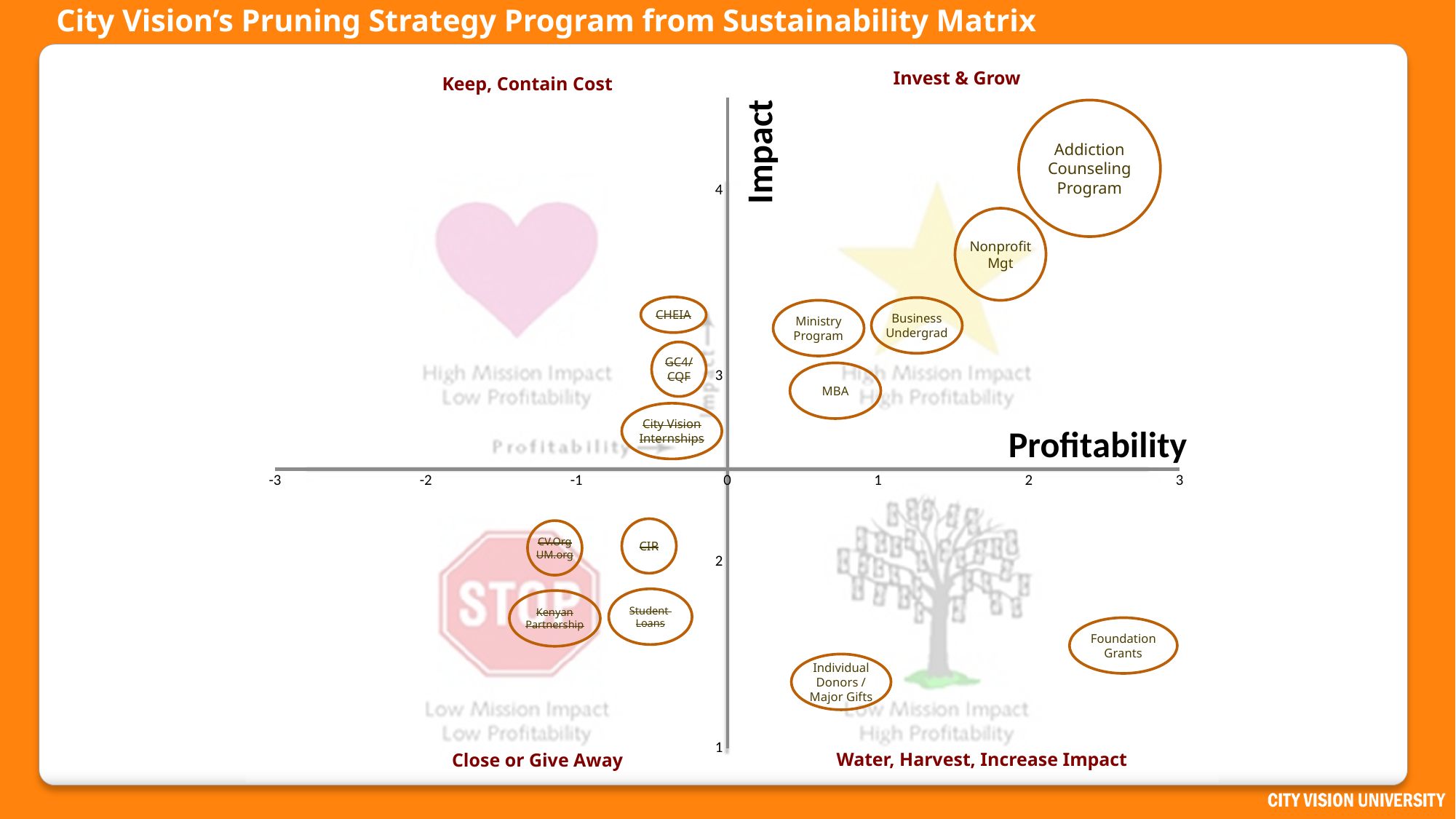
Which program has the highest Impact value? Addiction Counseling Program Is the Profitability value for Addiction Counseling Program greater or less than 2? greater Which program has the lowest Impact value? Individual Donors / Major Gifts What kind of chart is shown on the slide? Scatter (bubble) chart How many programs are plotted on the chart in total? 14 Is the Impact value for Ministry Program greater or less than 3? greater Is the Impact value for Foundation Grants greater or less than 2? less How many programs are plotted in the Invest & Grow quadrant? 5 Which has the higher Impact value, Addiction Counseling Program or Foundation Grants? Addiction Counseling Program How many programs are plotted in the Water, Harvest, Increase Impact quadrant? 2 What are the two axes of the chart labelled? Profitability (x) and Impact (y) Which quadrant label appears in the upper-right of the chart? Invest & Grow